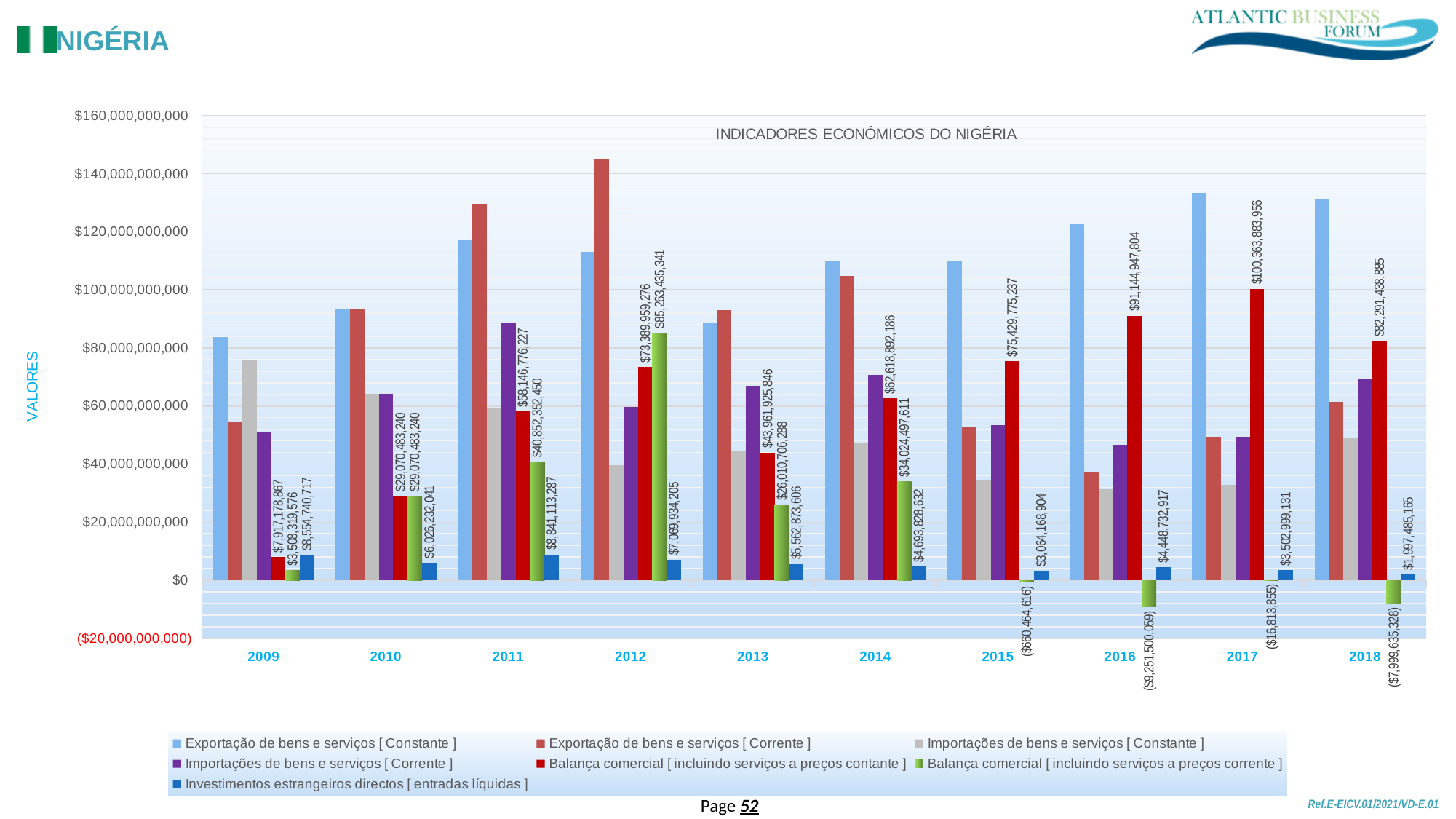
In which year is Balança comercial [incluindo serviços a preços contante] highest? 2017 What is the value of Investimentos estrangeiros directos [entradas líquidas] in 2009? $8,554,740,717 In which year is Investimentos estrangeiros directos [entradas líquidas] lowest? 2018 Is the value for Exportação de bens e serviços [Constante] in 2017 greater or less than $120,000,000,000? greater What is the value of Balança comercial [incluindo serviços a preços corrente] in 2016? ($9,251,500,059) What is the difference between Balança comercial a preços contante and Balança comercial a preços corrente in 2011? $17,294,423,777 How many years are shown on the x axis? 10 What is the title of the chart? INDICADORES ECONÓMICOS DO NIGÉRIA What is the value of Balança comercial [incluindo serviços a preços contante] in 2017? $100,363,883,956 In 2012, which is larger: Balança comercial a preços corrente or Balança comercial a preços contante? Balança comercial a preços corrente What kind of chart is shown on the slide? bar chart How many series does the legend list? 7